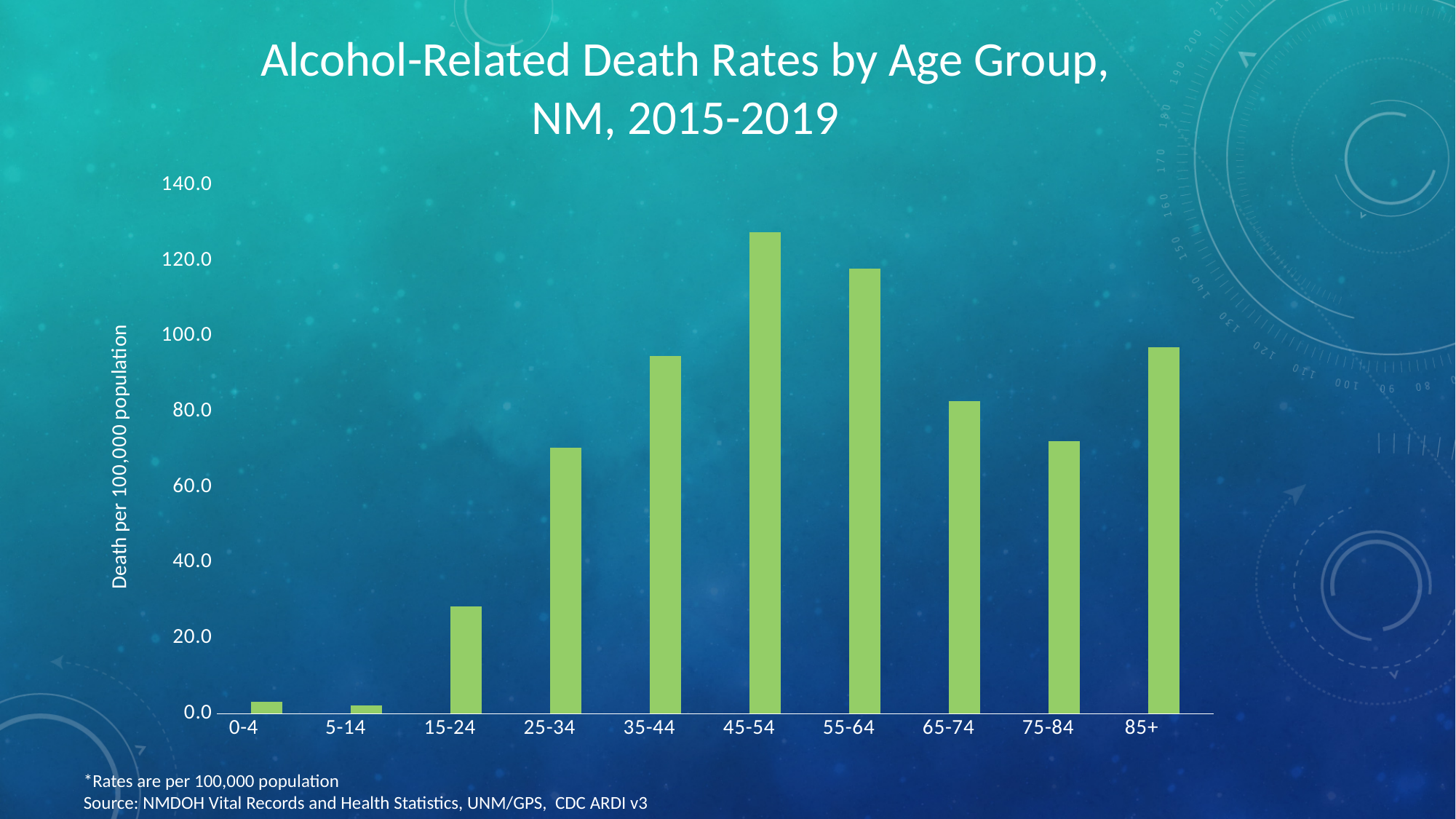
What is the label on the vertical axis of the chart? Death per 100,000 population Is the value for the 35-44 age group greater or less than 100? less Is the value for the 45-54 age group greater or less than 120? greater Which age group has the highest alcohol-related death rate? 45-54 Is the value for the 15-24 age group greater or less than 20? greater Which has the higher death rate, the 65-74 age group or the 75-84 age group? 65-74 What kind of chart is shown on the slide? bar chart How many age groups are shown on the x axis? 10 Which has the higher death rate, the 45-54 age group or the 55-64 age group? 45-54 Do the death rates rise or fall from the 0-4 age group to the 45-54 age group? rise